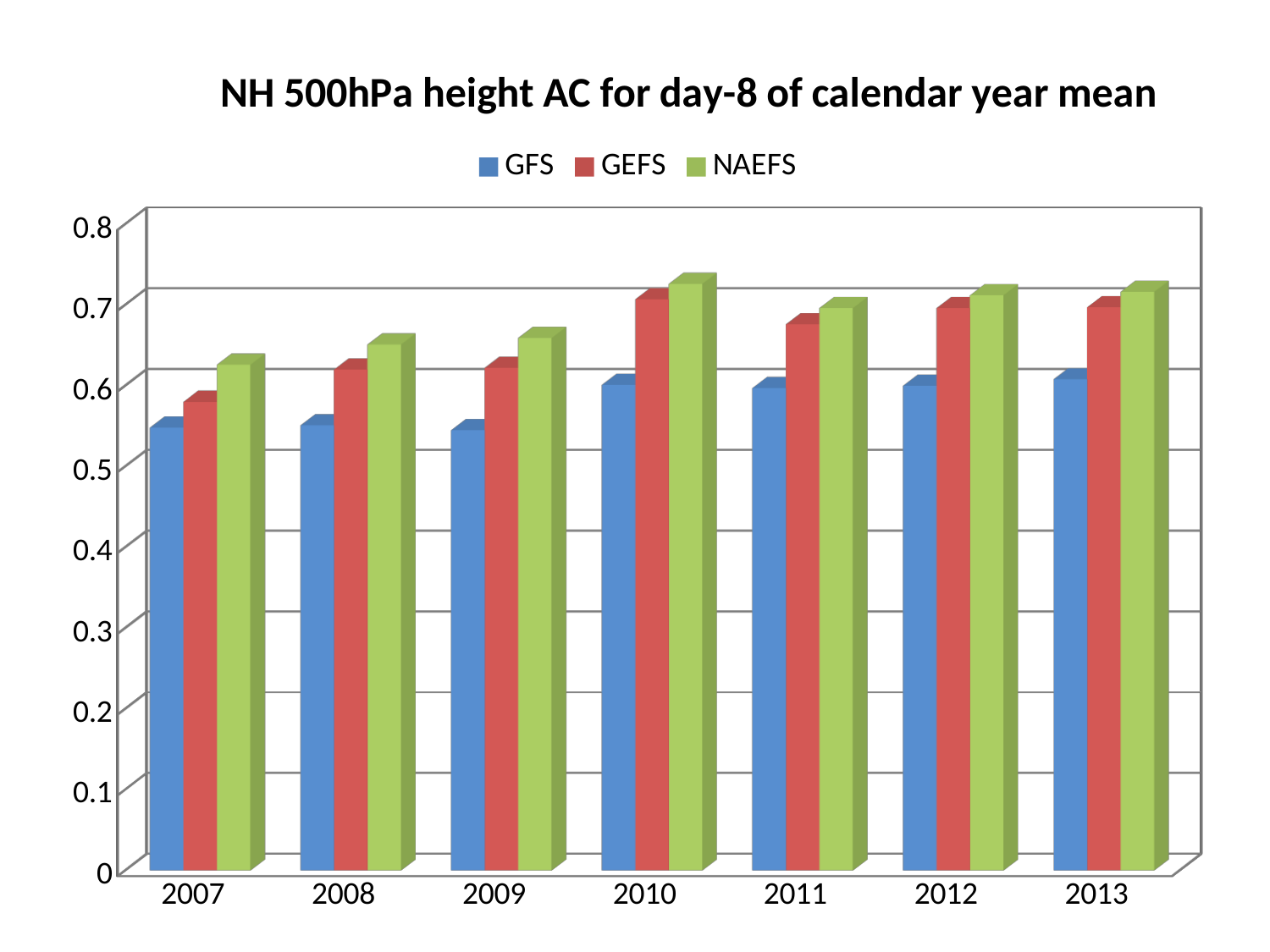
Which series is shown in green in the legend? NAEFS How many years are shown on the x axis? 7 Is the GFS value for 2007 greater or less than 0.6? less What is the title of the chart? NH 500hPa height AC for day-8 of calendar year mean Is the GEFS value for 2011 greater or less than 0.7? less What type of chart is shown on the slide? Bar chart Is the NAEFS value for 2007 greater or less than 0.6? greater Which series has the lowest value in 2010? GFS Is the GEFS value larger in 2007 or in 2010? 2010 How many series does the legend list? 3 Which series has the highest value in 2007? NAEFS